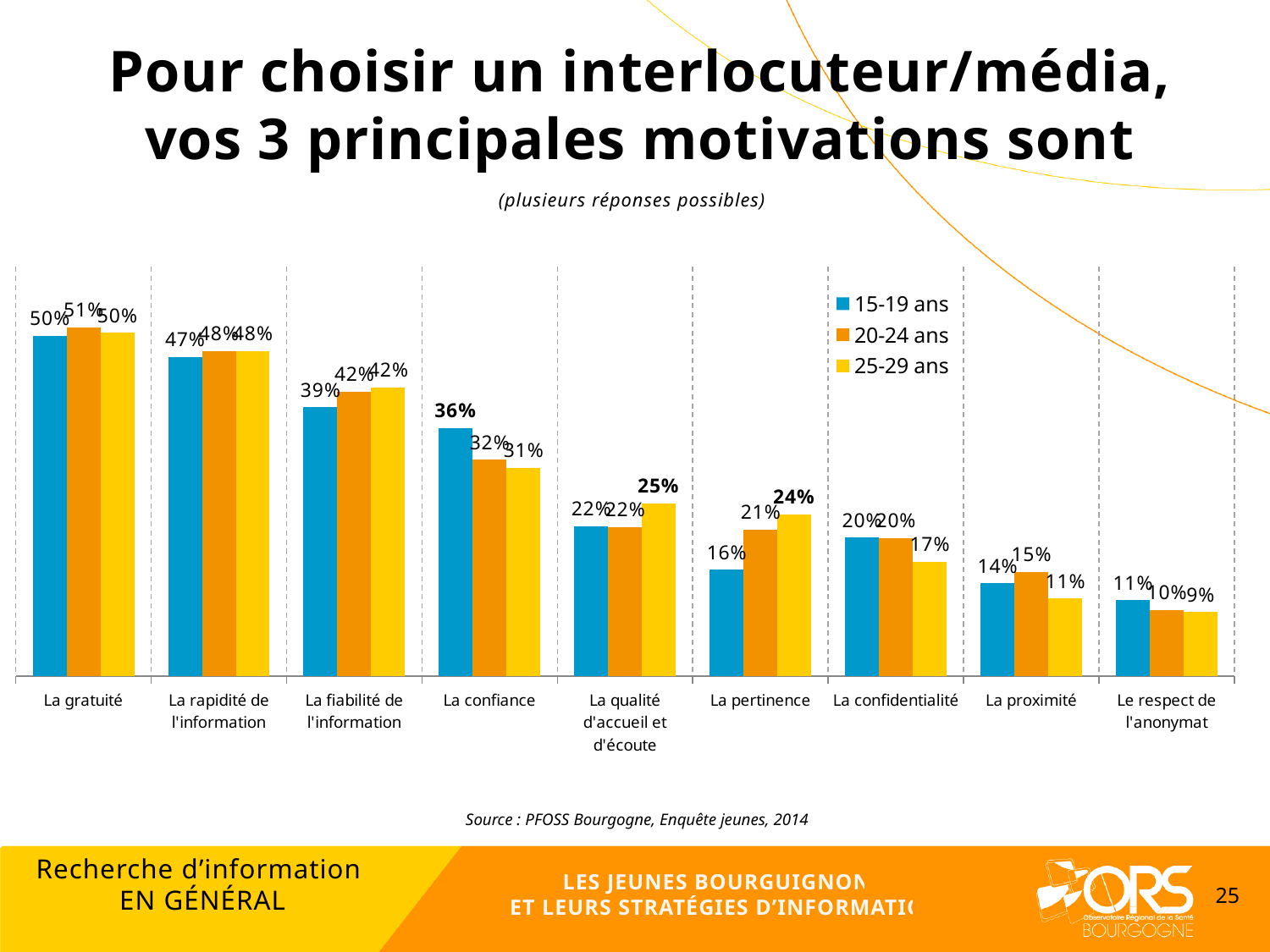
Which age group is shown in yellow in the legend? 25-29 ans For La confiance, which is larger: the 15-19 ans value or the 25-29 ans value? 15-19 ans What is the value for 25-29 ans for La pertinence? 24% How many categories are shown on the x axis? 9 What kind of chart is shown on the slide? Bar chart What is the value for 20-24 ans for La fiabilité de l'information? 42% What is the difference between the 25-29 ans and 15-19 ans values for La pertinence? 8% Which category has the lowest value for the 15-19 ans series? Le respect de l'anonymat Which category has the highest value for the 20-24 ans series? La gratuité How many series does the legend list? 3 What is the value for 25-29 ans for Le respect de l'anonymat? 9% What is the value for 15-19 ans for La confiance? 36%